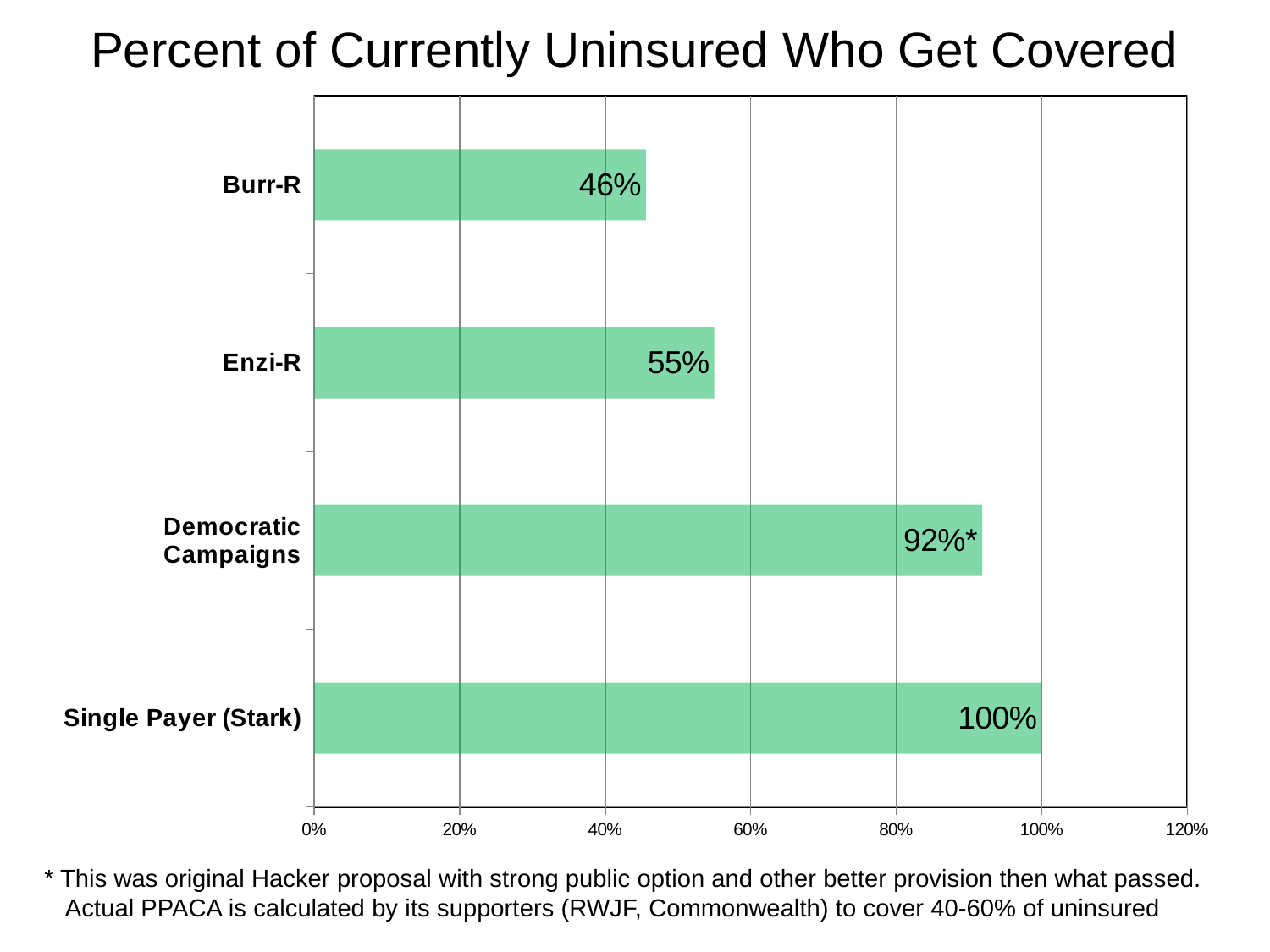
Which category has the lowest value? Burr-R What is the value for Burr-R? 46% What is the value for Democratic Campaigns? 92% What is the value for Enzi-R? 55% What kind of chart is shown on the slide? Bar chart What is the difference between the values for Enzi-R and Burr-R? 9% How many categories are shown in the chart? 4 What is the title of the chart? Percent of Currently Uninsured Who Get Covered Which category has the highest value? Single Payer (Stark) What is the difference between the values for Single Payer (Stark) and Democratic Campaigns? 8% What is the value for Single Payer (Stark)? 100% Which is larger, the value for Enzi-R or the value for Democratic Campaigns? Democratic Campaigns